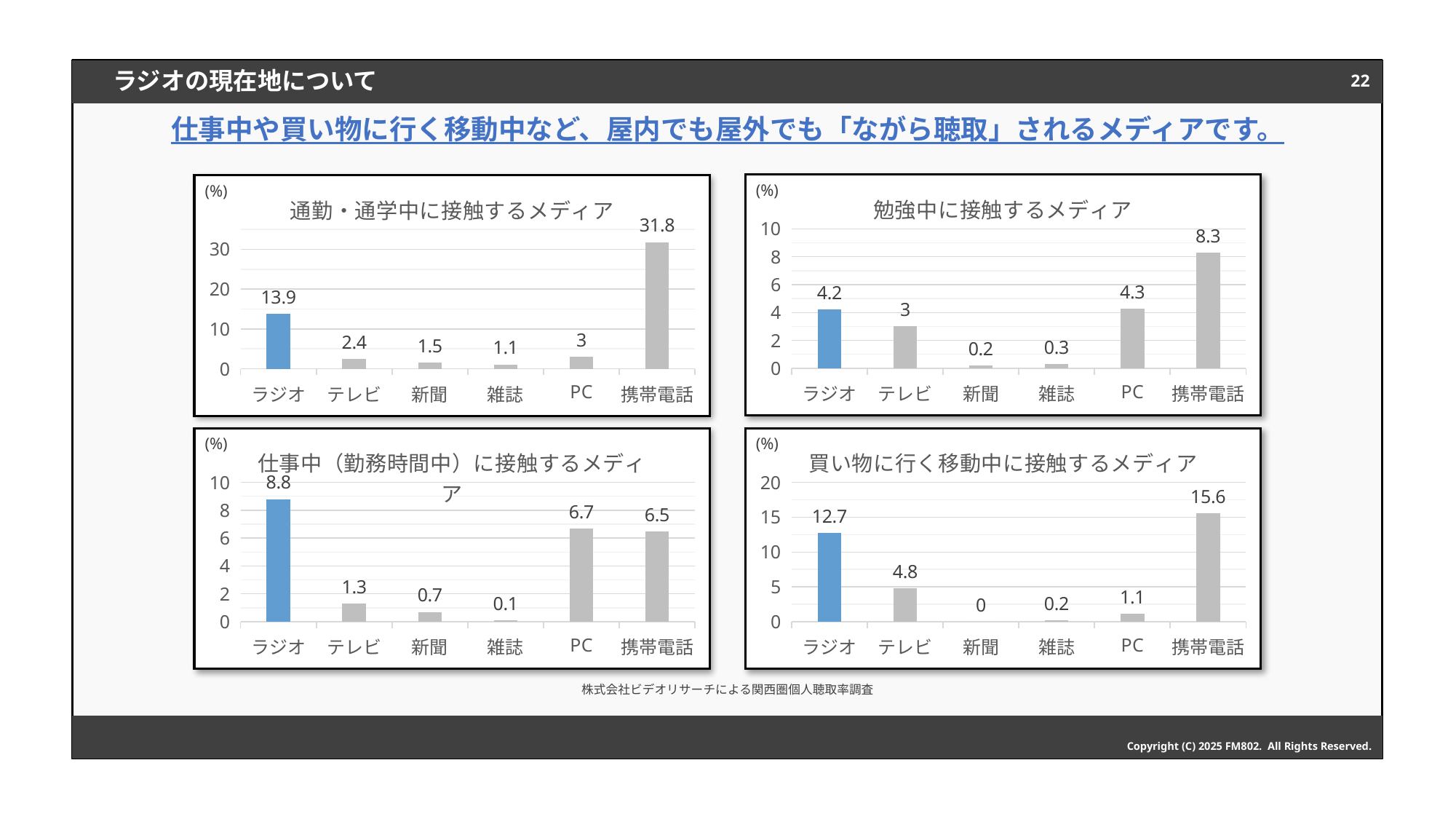
In the 買い物に行く移動中に接触するメディア chart, what is the difference between ラジオ and テレビ? 7.9 In the 仕事中（勤務時間中）に接触するメディア chart, what is the value for 新聞? 0.7 In the 通勤・通学中に接触するメディア chart, which category has the highest value? 携帯電話 In the 勉強中に接触するメディア chart, what is the difference between 携帯電話 and ラジオ? 4.1 In the 通勤・通学中に接触するメディア chart, which category has the lowest value? 雑誌 What kind of chart is the 通勤・通学中に接触するメディア chart? Bar chart In the 買い物に行く移動中に接触するメディア chart, what is the value for 携帯電話? 15.6 How many categories are shown in the 勉強中に接触するメディア chart? 6 In the 仕事中（勤務時間中）に接触するメディア chart, which is larger, PC or 携帯電話? PC In the 勉強中に接触するメディア chart, what is the value for PC? 4.3 In the 通勤・通学中に接触するメディア chart, what is the value for ラジオ? 13.9 In the 買い物に行く移動中に接触するメディア chart, which category has the lowest value? 新聞